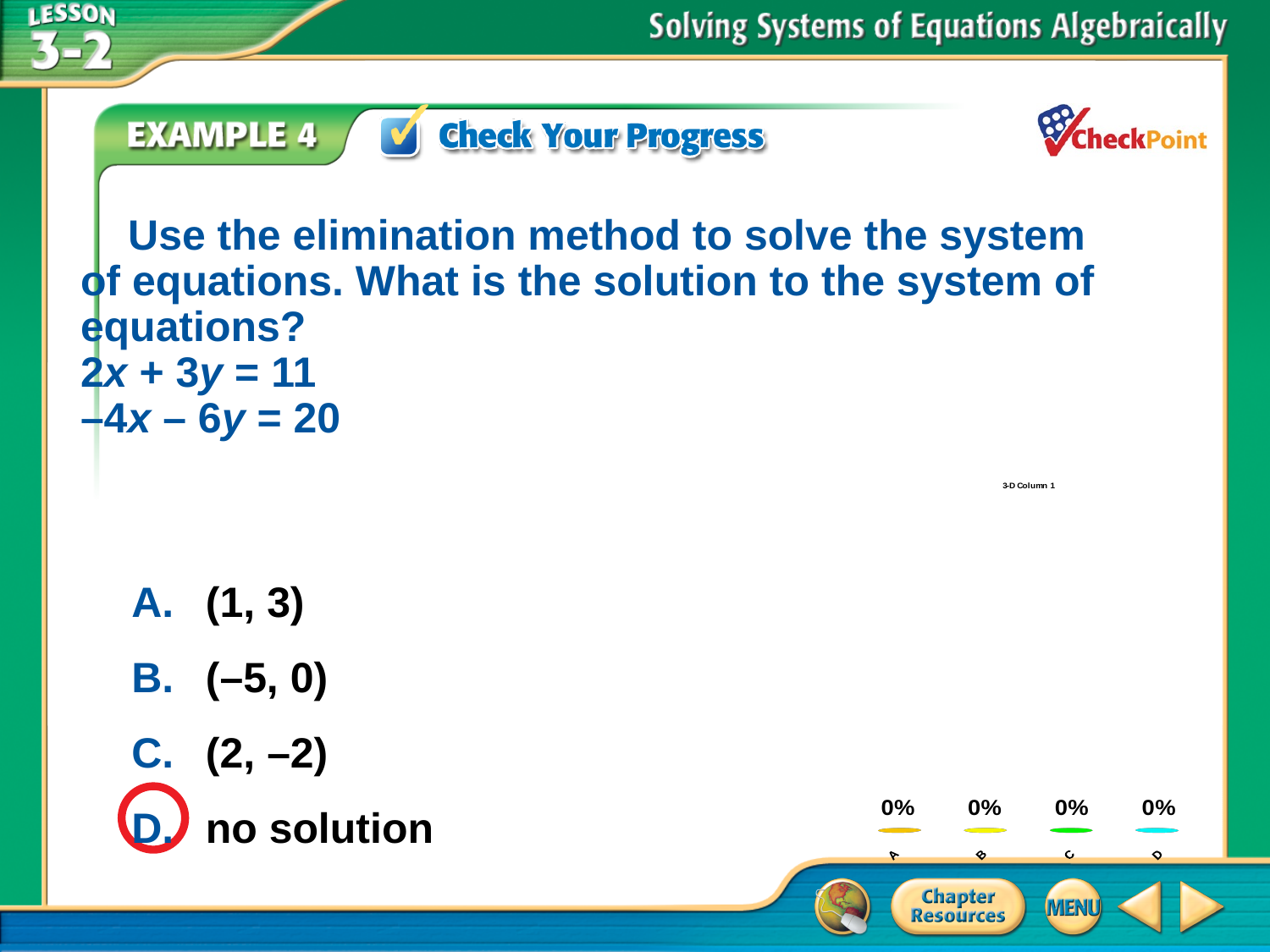
What are the category labels along the x axis of the chart? A, B, C, D What kind of chart is shown on the slide? bar chart What value is shown for category B in the chart? 0% What is the difference between the values for A and D in the chart? 0% What value is shown for category C in the chart? 0% How many categories are plotted in the chart? 4 What value is shown for category A in the chart? 0% What value is shown for category D in the chart? 0%